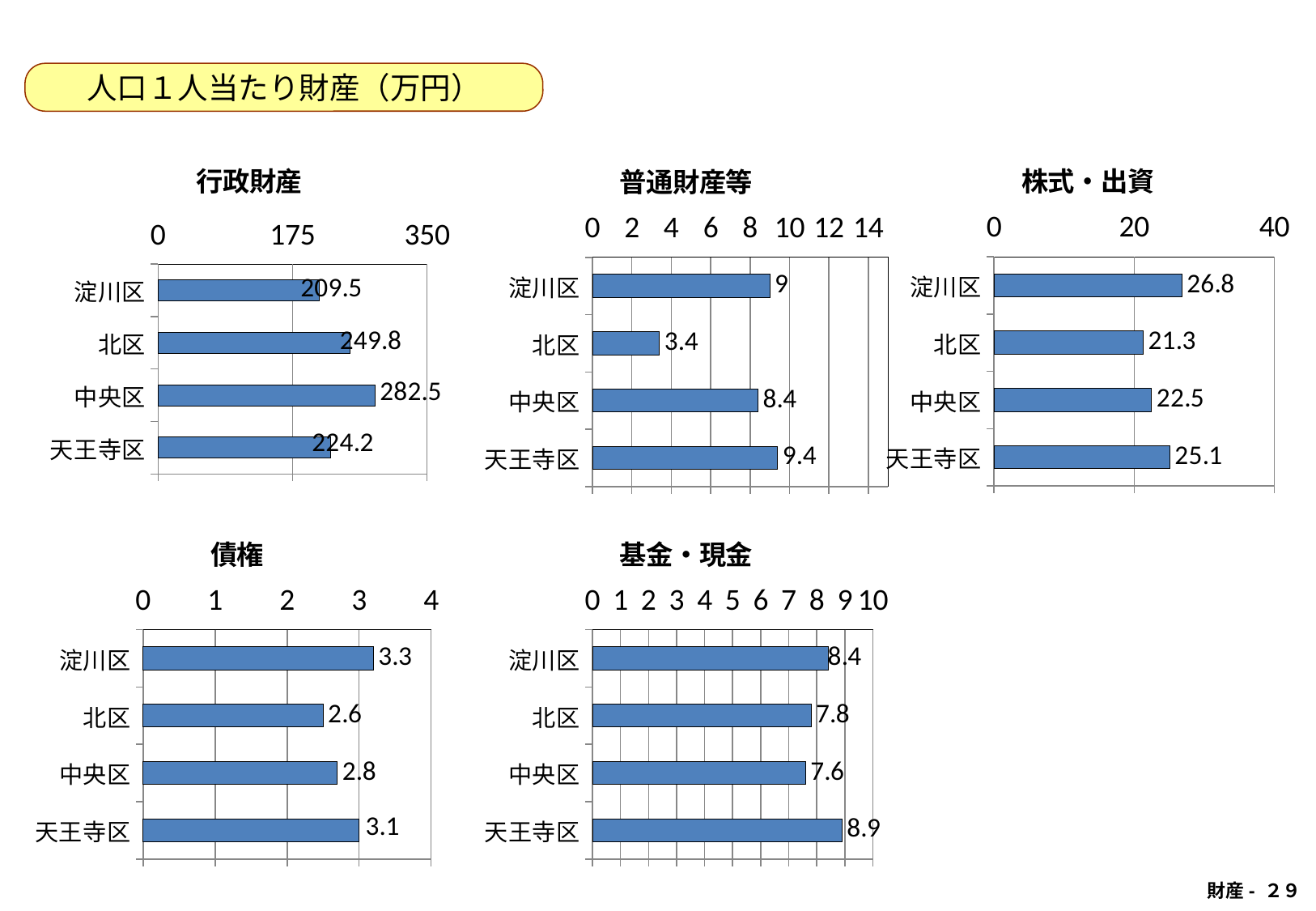
How many charts are on the slide? 5 In the 普通財産等 chart, which district has the highest value? 天王寺区 In the 普通財産等 chart, what is the value for 北区? 3.4 In the 債権 chart, what is the value for 天王寺区? 3.1 In the 基金・現金 chart, what is the value for 中央区? 7.6 What kind of chart is the 行政財産 chart? Bar chart In the 債権 chart, which is larger, 北区 or 中央区? 中央区 In the 行政財産 chart, which district has the lowest value? 淀川区 In the 株式・出資 chart, which district has the highest value? 淀川区 In the 株式・出資 chart, what is the difference between 淀川区 and 北区? 5.5 In the 基金・現金 chart, what is the difference between 天王寺区 and 北区? 1.1 In the 行政財産 chart, what is the value for 中央区? 282.5